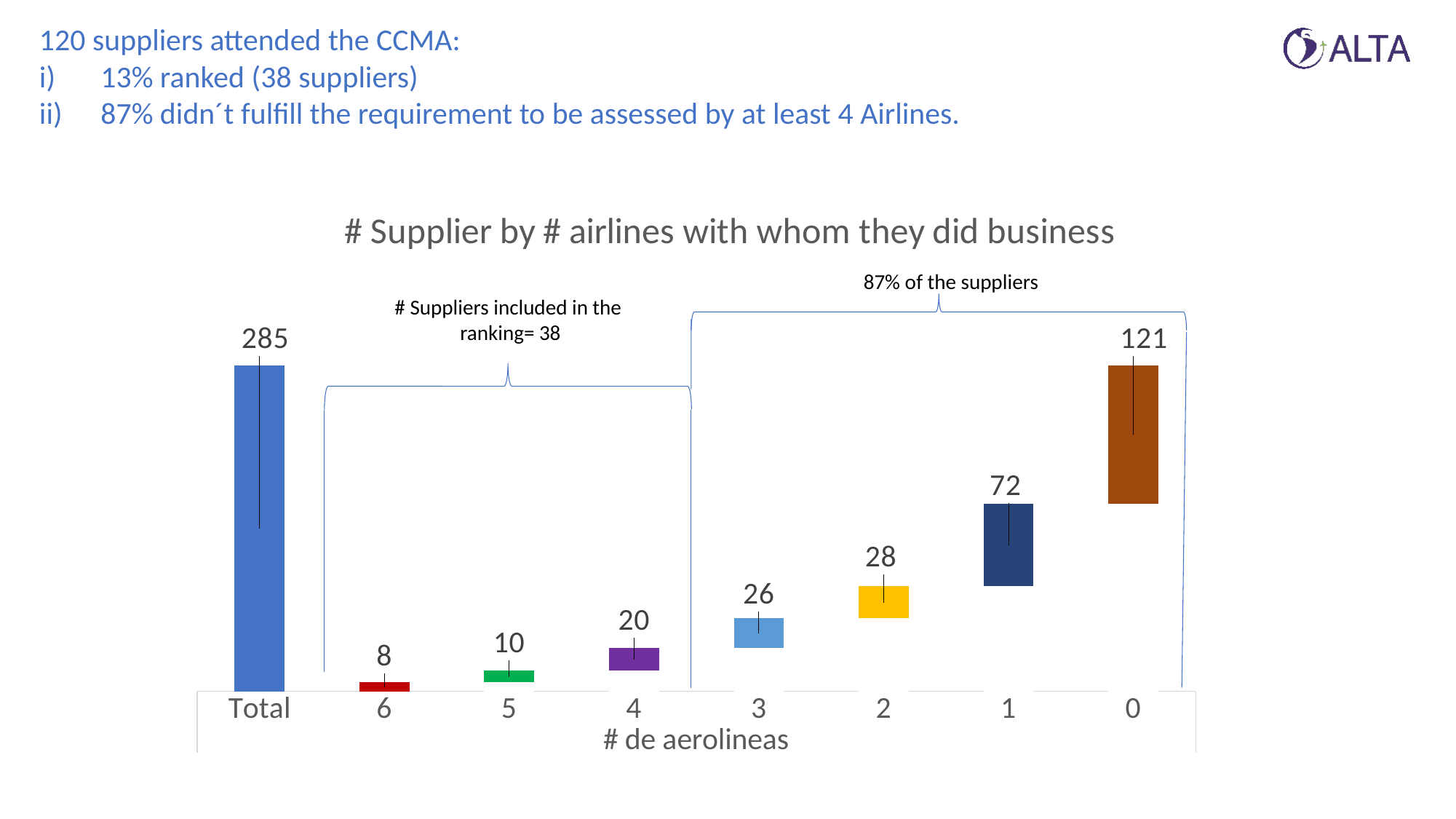
What is the x-axis title of the chart? # de aerolineas What is the value for the category 4 on the x axis? 20 What is the value for the Total bar? 285 How many bars are plotted in the chart, including the Total bar? 8 Excluding the Total bar, which category has the highest value? 0 What kind of chart is shown on the slide? Bar chart What is the title of the chart? # Supplier by # airlines with whom they did business What is the difference between the values for category 0 and category 1? 49 Excluding the Total bar, which category has the lowest value? 6 What is the value for the category 1 on the x axis? 72 How many suppliers did business with 0 airlines? 121 Which is larger, the value for category 3 or the value for category 2? 2